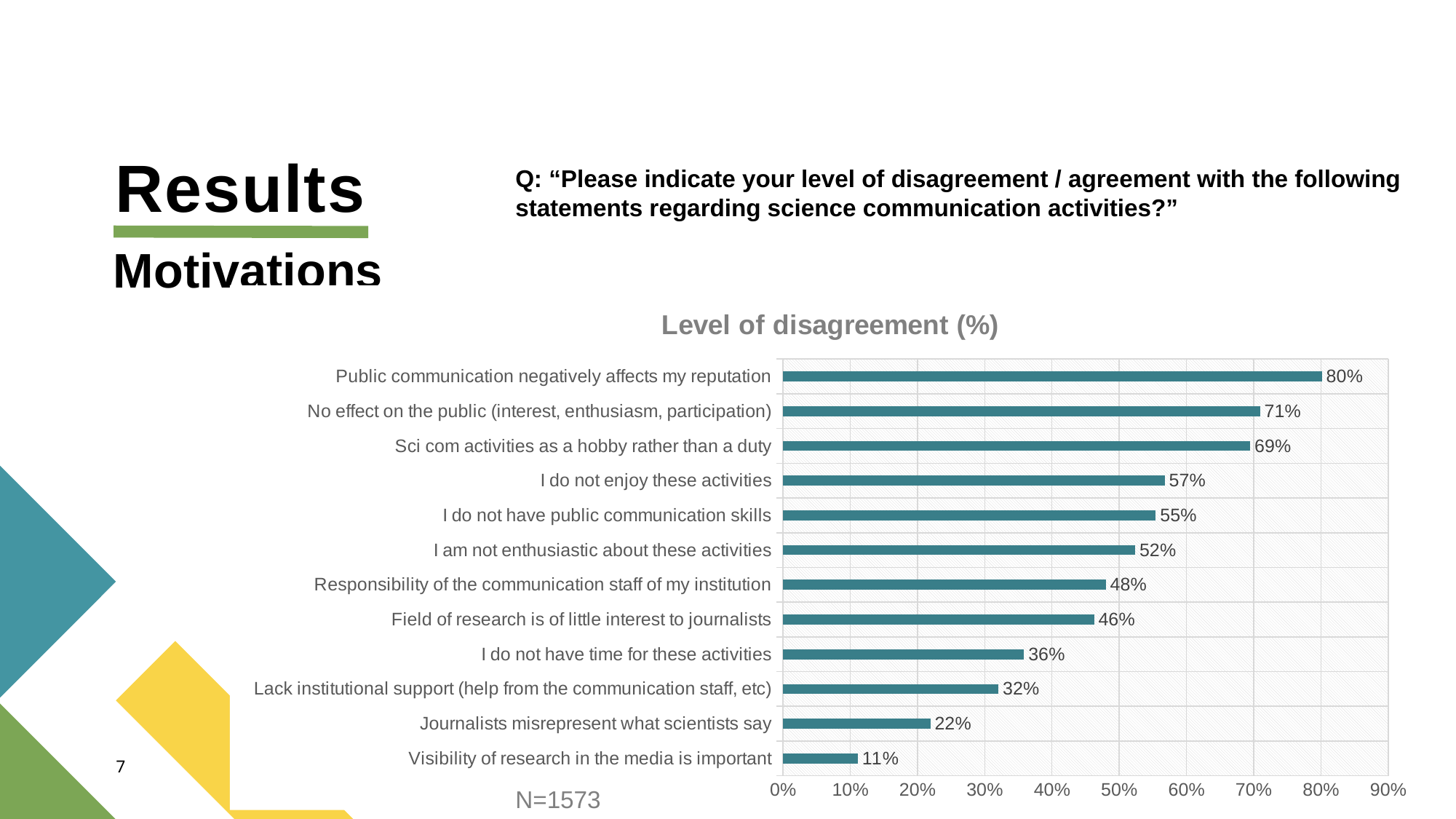
Which has a higher level of disagreement: "I do not have public communication skills" or "Field of research is of little interest to journalists"? I do not have public communication skills What is the level of disagreement for "Journalists misrepresent what scientists say"? 22% What is the level of disagreement for "I do not have time for these activities"? 36% What is the difference in level of disagreement between "I do not enjoy these activities" and "Visibility of research in the media is important"? 46% What type of chart is shown on the slide? Bar chart How many statements are shown in the chart? 12 Which statement has the lowest level of disagreement? Visibility of research in the media is important Is the level of disagreement for "Lack institutional support (help from the communication staff, etc)" greater or less than 40%? less What is the level of disagreement for "Public communication negatively affects my reputation"? 80% What is the title of the chart? Level of disagreement (%) What is the difference in level of disagreement between "No effect on the public (interest, enthusiasm, participation)" and "Sci com activities as a hobby rather than a duty"? 2% Which statement has the highest level of disagreement? Public communication negatively affects my reputation